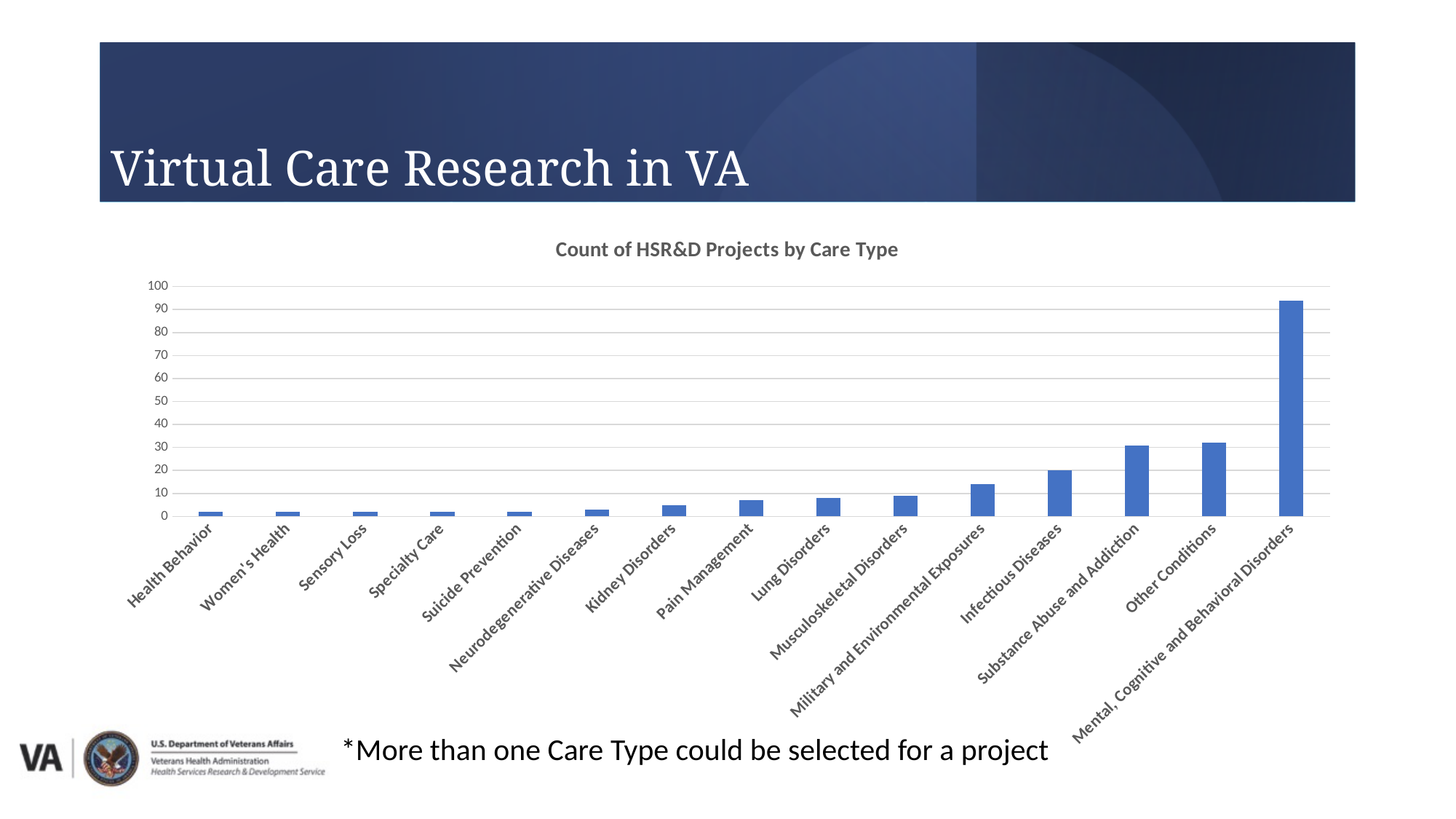
Which has a higher count: Substance Abuse and Addiction or Infectious Diseases? Substance Abuse and Addiction Which has a higher count: Military and Environmental Exposures or Pain Management? Military and Environmental Exposures Which care type has the highest count of HSR&D projects? Mental, Cognitive and Behavioral Disorders What is the title of the chart? Count of HSR&D Projects by Care Type Is the value for Military and Environmental Exposures greater or less than 10? greater What kind of chart is shown on the slide? Bar chart Is the value for Kidney Disorders greater or less than 10? less Do the bar values generally rise or fall moving from left to right along the x axis? Rise Is the value for Substance Abuse and Addiction greater or less than 20? greater How many care type categories are plotted in the chart? 15